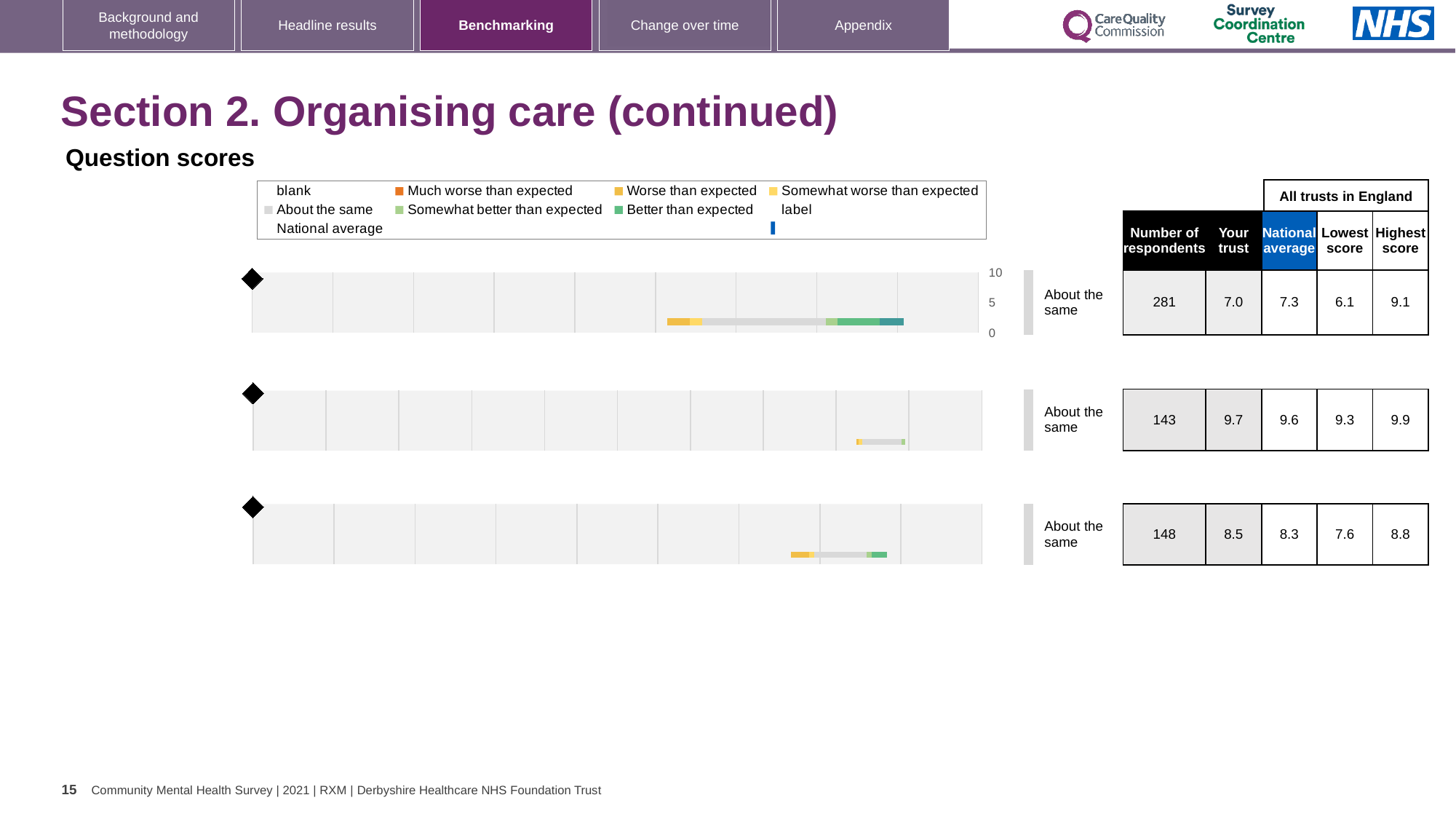
How many benchmarking charts are shown on the slide? 3 For the top chart, what is the 'Your trust' score shown in the table? 7.0 What is the highest value shown on the vertical axis of the top chart? 10 For the bottom chart, what is the number of respondents shown in the table? 148 Which of the three charts has the highest 'Your trust' score in the table? the middle chart For the top chart, what is the national average shown in the table? 7.3 What benchmark category is written next to each of the three charts? About the same What kind of chart is used to show the question scores on this slide? bar chart For the bottom chart, what is the difference between the highest score and the lowest score across all trusts in England? 1.2 For the top chart, which is larger: the 'Your trust' score or the national average? National average Which legend entry is shown with a dark orange colour? Much worse than expected For the middle chart, what is the 'Your trust' score shown in the table? 9.7